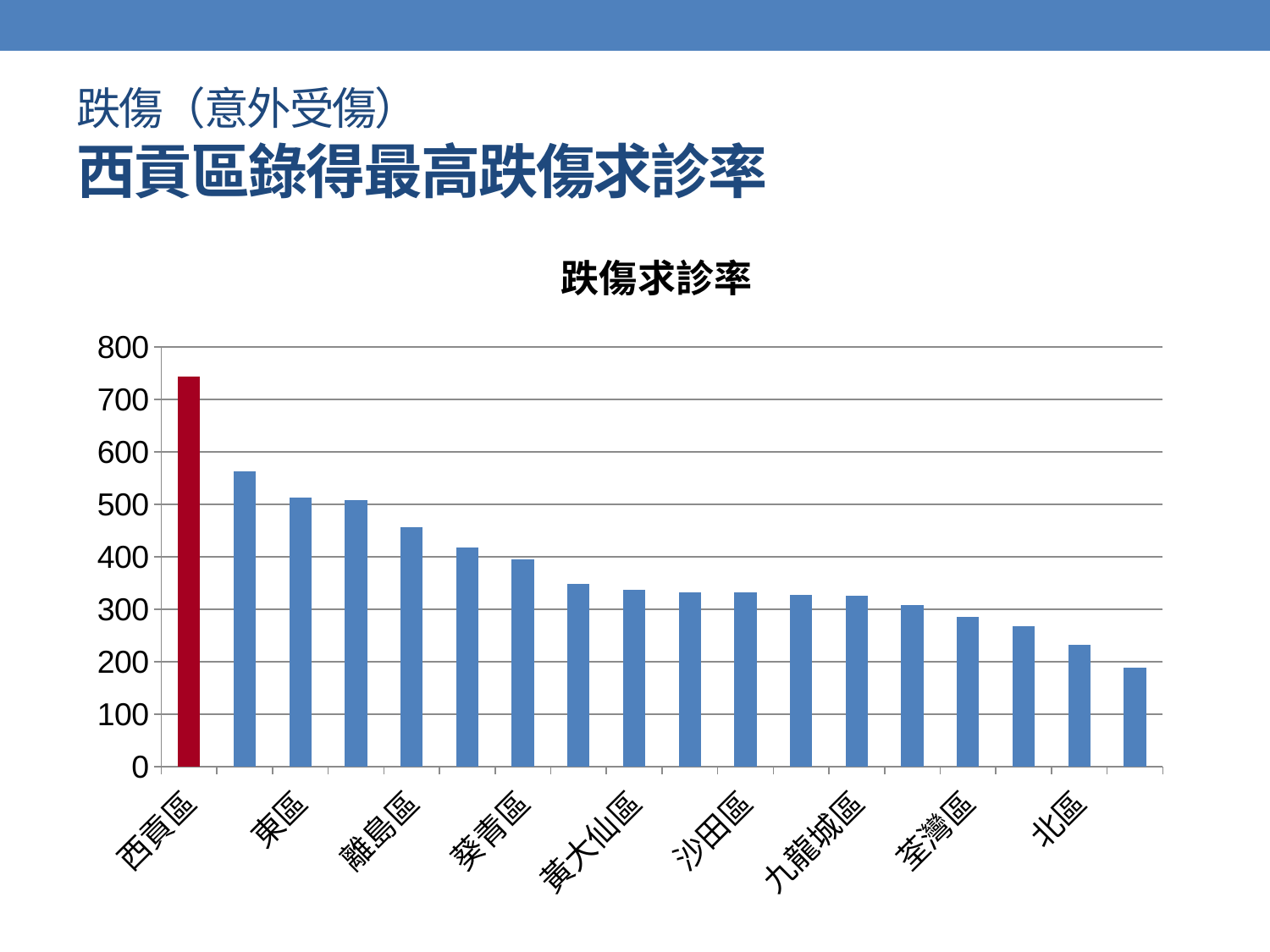
Is the value for 西貢區 greater or less than 700? greater Which district has the highest 跌傷求診率? 西貢區 Do the values rise or fall from left to right along the x axis? fall What is the title of the chart? 跌傷求診率 How many bars are plotted in the chart? 18 Is the value for 荃灣區 greater or less than 300? less Which bar is coloured red instead of blue? 西貢區 What kind of chart is shown on the slide? bar chart Is the value for 離島區 greater or less than 500? less Which is larger, the value for 東區 or the value for 離島區? 東區